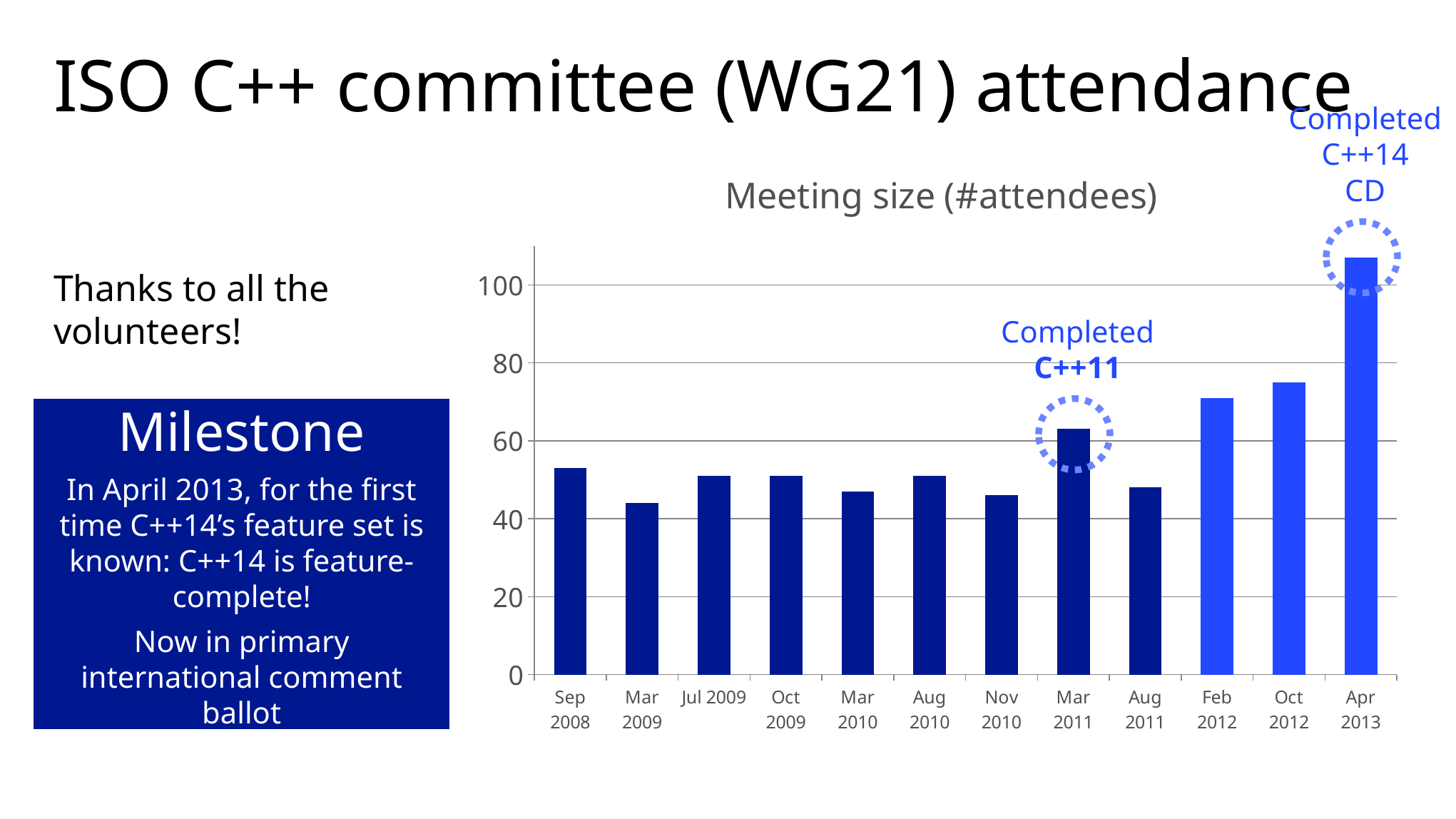
Is the value for Feb 2012 greater or less than 80? less Which meeting had more attendees, Mar 2011 or Aug 2011? Mar 2011 Is the value for Sep 2008 greater or less than 60? less What is the title of the chart? Meeting size (#attendees) Is the value for Apr 2013 greater or less than 100? greater Do the attendance values rise or fall from Aug 2011 to Apr 2013? rise How many meetings (bars) are plotted in the chart? 12 Which meeting's bar is annotated with "Completed C++11"? Mar 2011 Which meeting has the highest number of attendees? Apr 2013 Which meeting had more attendees, Oct 2012 or Mar 2011? Oct 2012 What type of chart is shown on the slide? bar chart